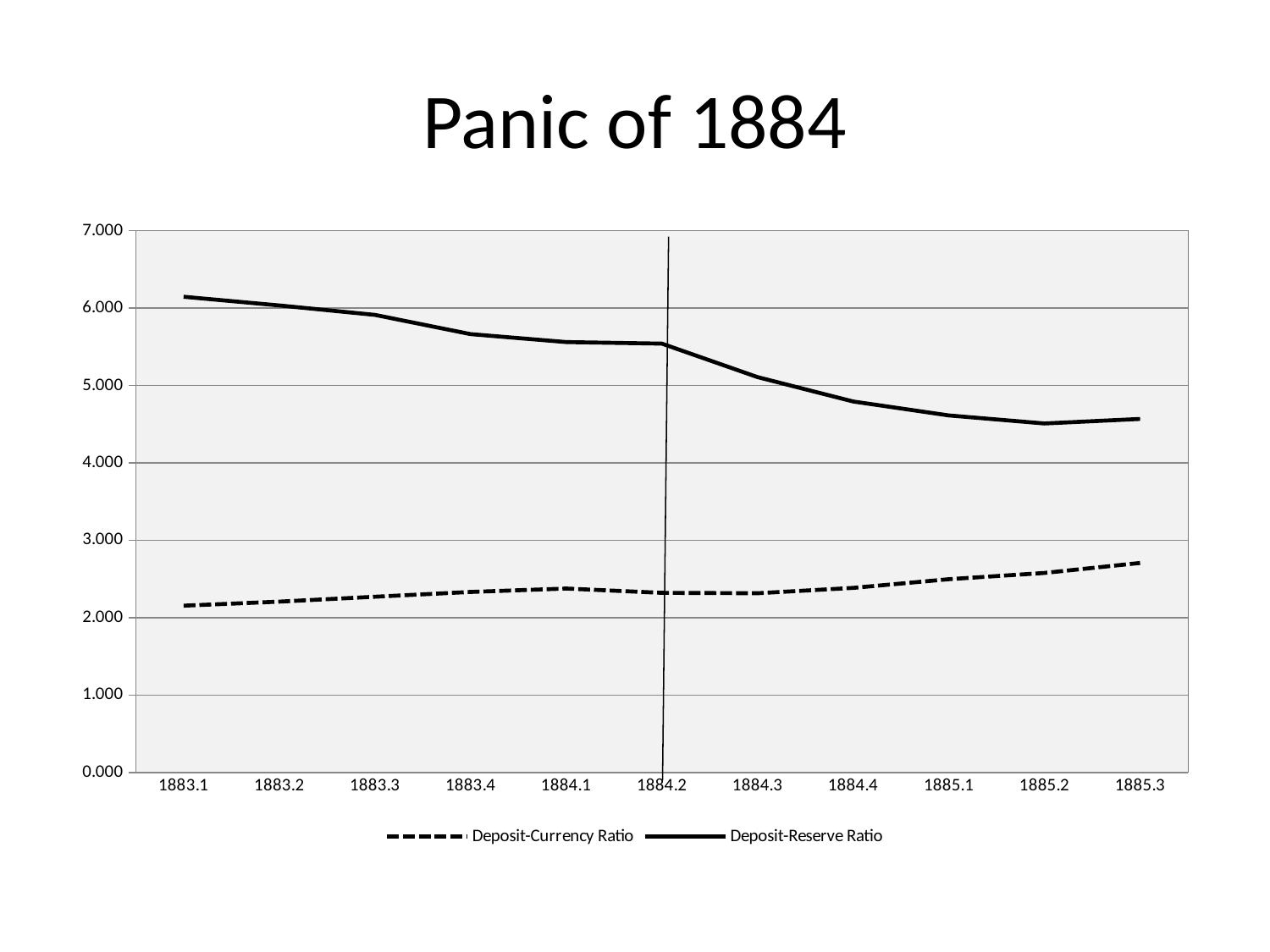
What is the title of the slide? Panic of 1884 Is the Deposit-Reserve Ratio at 1884.4 greater or less than 5.000? less Which series is drawn with a dashed line? Deposit-Currency Ratio How many time periods are shown on the x axis? 11 How many series does the legend list? 2 At 1884.2, which series has the larger value, Deposit-Currency Ratio or Deposit-Reserve Ratio? Deposit-Reserve Ratio At which period is the Deposit-Reserve Ratio highest? 1883.1 What kind of chart is shown on the slide? Line chart At which period is the Deposit-Currency Ratio lowest? 1883.1 Does the Deposit-Currency Ratio generally rise or fall from 1883.1 to 1885.3? Rise At which period is the Deposit-Currency Ratio highest? 1885.3 Does the Deposit-Reserve Ratio generally rise or fall from 1883.1 to 1885.3? Fall